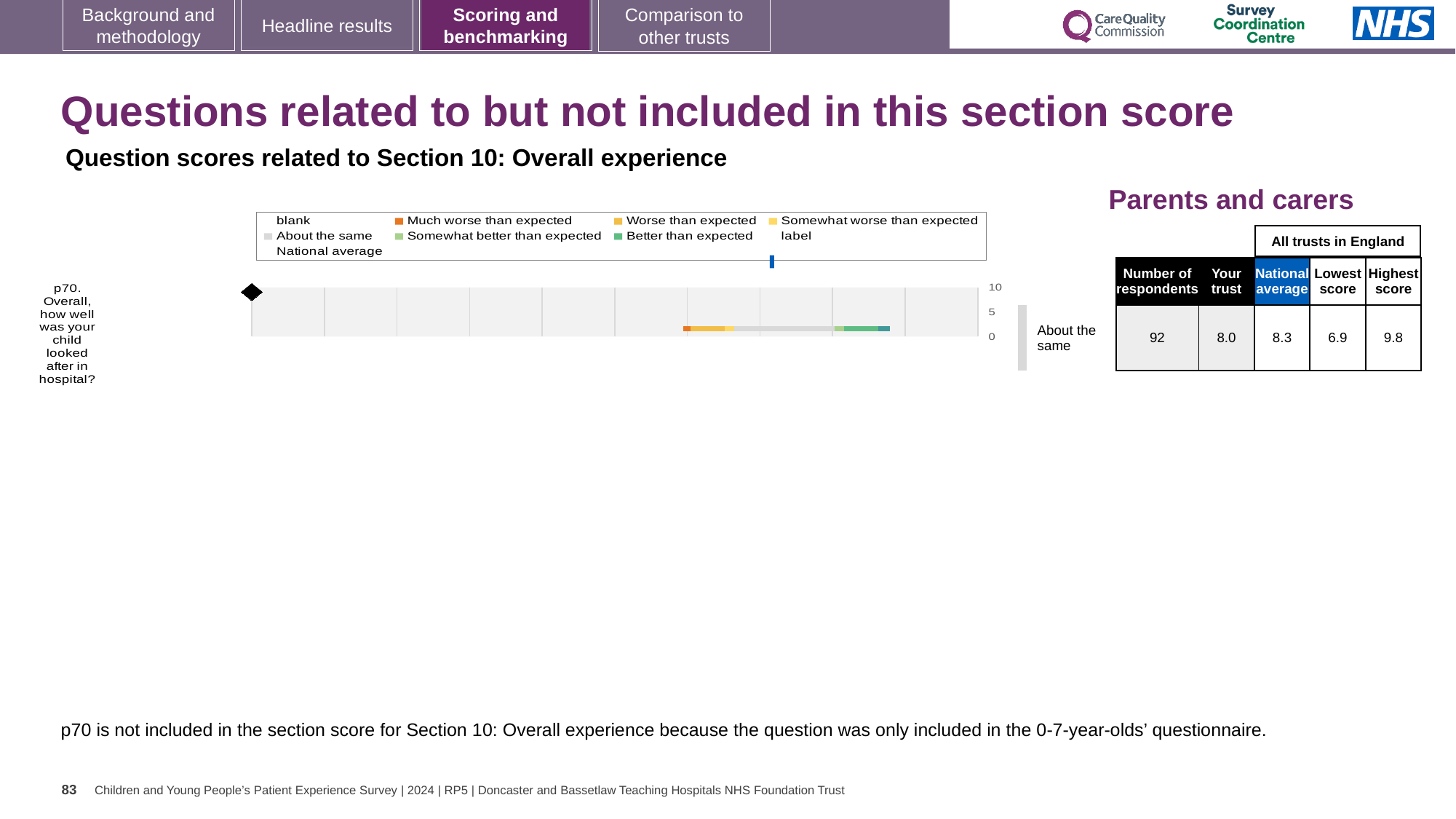
What is the 'Your trust' score for p70 in the Parents and carers table? 8.0 What benchmark label is shown to the right of the p70 bar? About the same What is the national average score for p70? 8.3 How many questions are plotted in the chart? 1 How many respondents answered p70? 92 Which legend entry is shown in orange? Much worse than expected Which is larger for p70, the 'Your trust' score or the national average? National average What kind of chart is used to show the p70 question score? bar chart What is the difference between the highest and lowest trust scores for p70? 2.9 What is the highest score among all trusts in England for p70? 9.8 What is the difference between the national average and the 'Your trust' score for p70? 0.3 What is the lowest score among all trusts in England for p70? 6.9